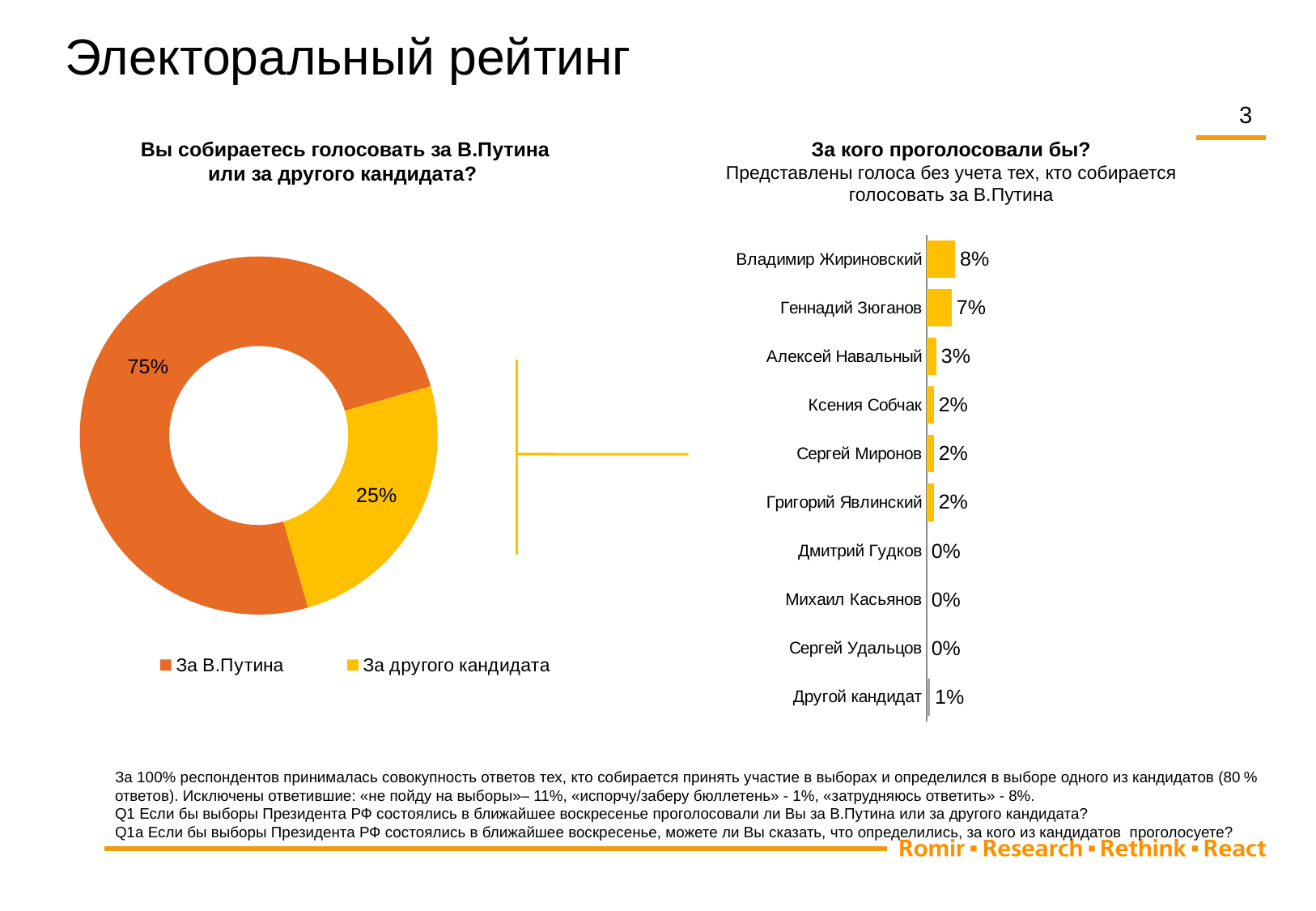
What kind of chart is the right chart on the slide? Bar chart In the left chart ("Вы собираетесь голосовать за В.Путина или за другого кандидата?"), what share of respondents would vote for В.Путин? 75% In the right chart, what is the difference between the values for Владимир Жириновский and Геннадий Зюганов? 1 percentage point In the right chart, how many candidate categories are shown? 10 In the left chart, what is the difference between the share for В.Путин and the share for another candidate? 50 percentage points In the left chart, what share of respondents would vote for another candidate ("За другого кандидата")? 25% In the right chart ("За кого проголосовали бы?"), what is the value for Владимир Жириновский? 8% In the right chart, which is larger: the value for Геннадий Зюганов or the value for Ксения Собчак? Геннадий Зюганов In the right chart, what is the value for Алексей Навальный? 3% How many entries does the legend of the left chart list? 2 What kind of chart is the left chart on the slide? Pie (doughnut) chart In the right chart, which candidate has the highest value? Владимир Жириновский